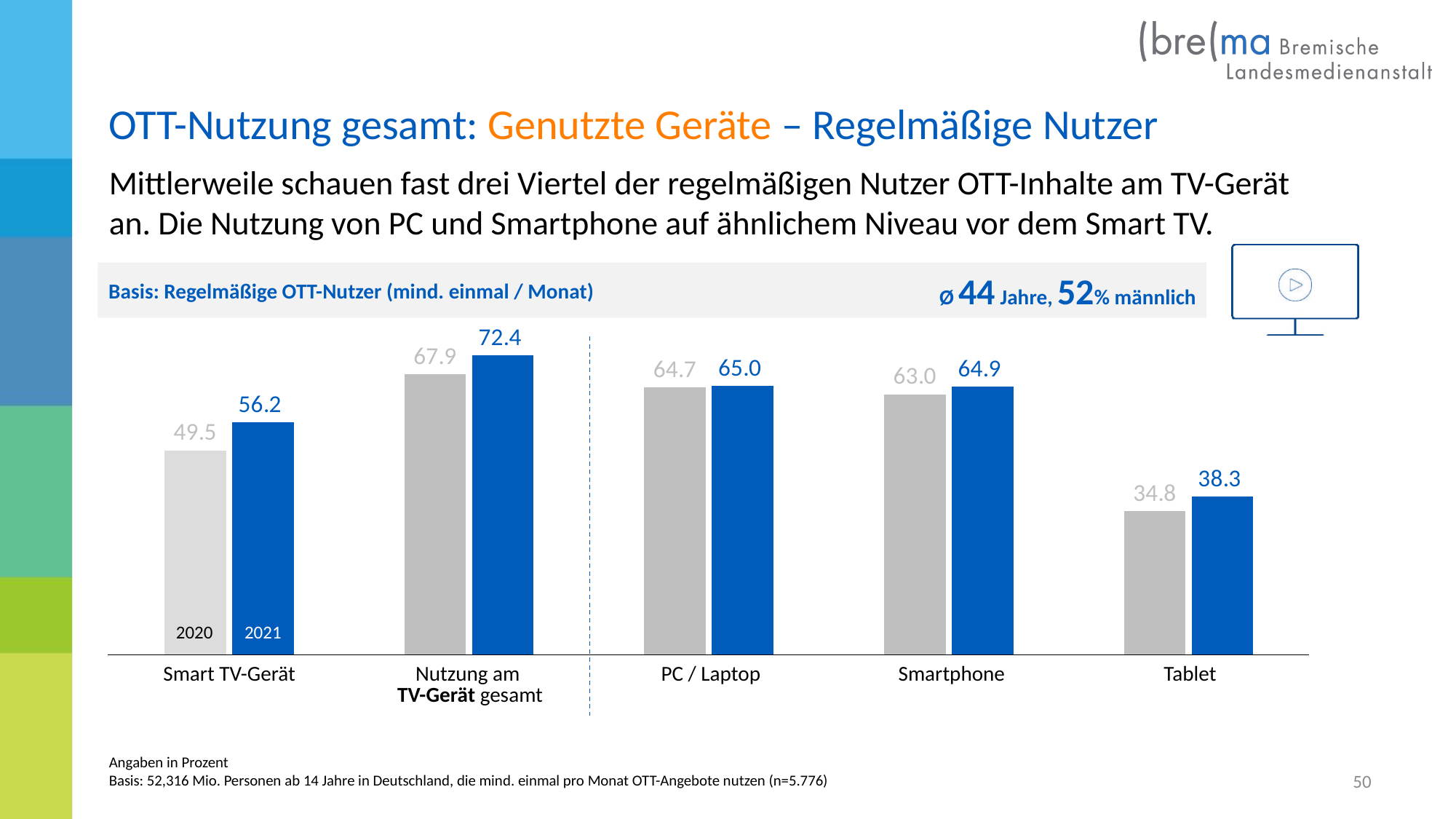
What is the 2020 value for Tablet? 34.8 How many series (years) does the chart compare? 2 What is the 2021 value for Nutzung am TV-Gerät gesamt? 72.4 How many device categories are shown on the x axis? 5 What is the 2020 value for Smartphone? 63.0 What is the difference between the 2021 values for PC / Laptop and Tablet? 26.7 What is the 2021 value for Smart TV-Gerät? 56.2 What is the difference between the 2021 and 2020 values for Smart TV-Gerät? 6.7 Which category has the lowest 2020 value? Tablet What kind of chart is shown on the slide? Bar chart Which is larger: the 2020 value for PC / Laptop or the 2020 value for Smartphone? PC / Laptop Which category has the highest 2021 value? Nutzung am TV-Gerät gesamt